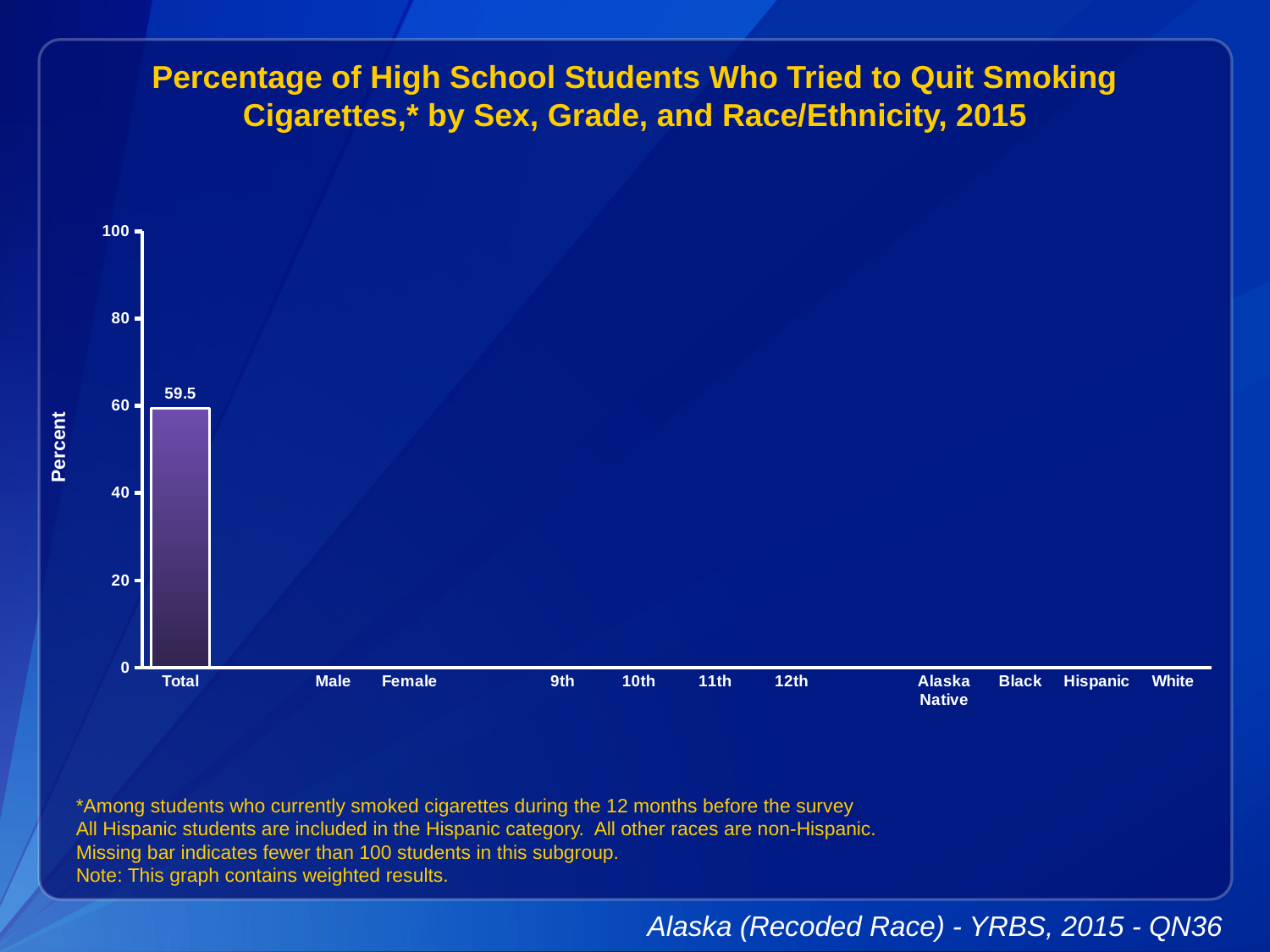
What kind of chart is shown on the slide? bar chart How many bars are plotted on the chart? 1 Which category has a bar plotted on the chart? Total What is the value for Total? 59.5 What is the label of the y axis? Percent What is the maximum value shown on the y axis? 100 Is the value for Total greater or less than 40? greater How many categories are labeled on the x axis? 11 Is there a bar plotted for Male? No Is there a bar plotted for 12th? No Is the value for Total greater or less than 60? less